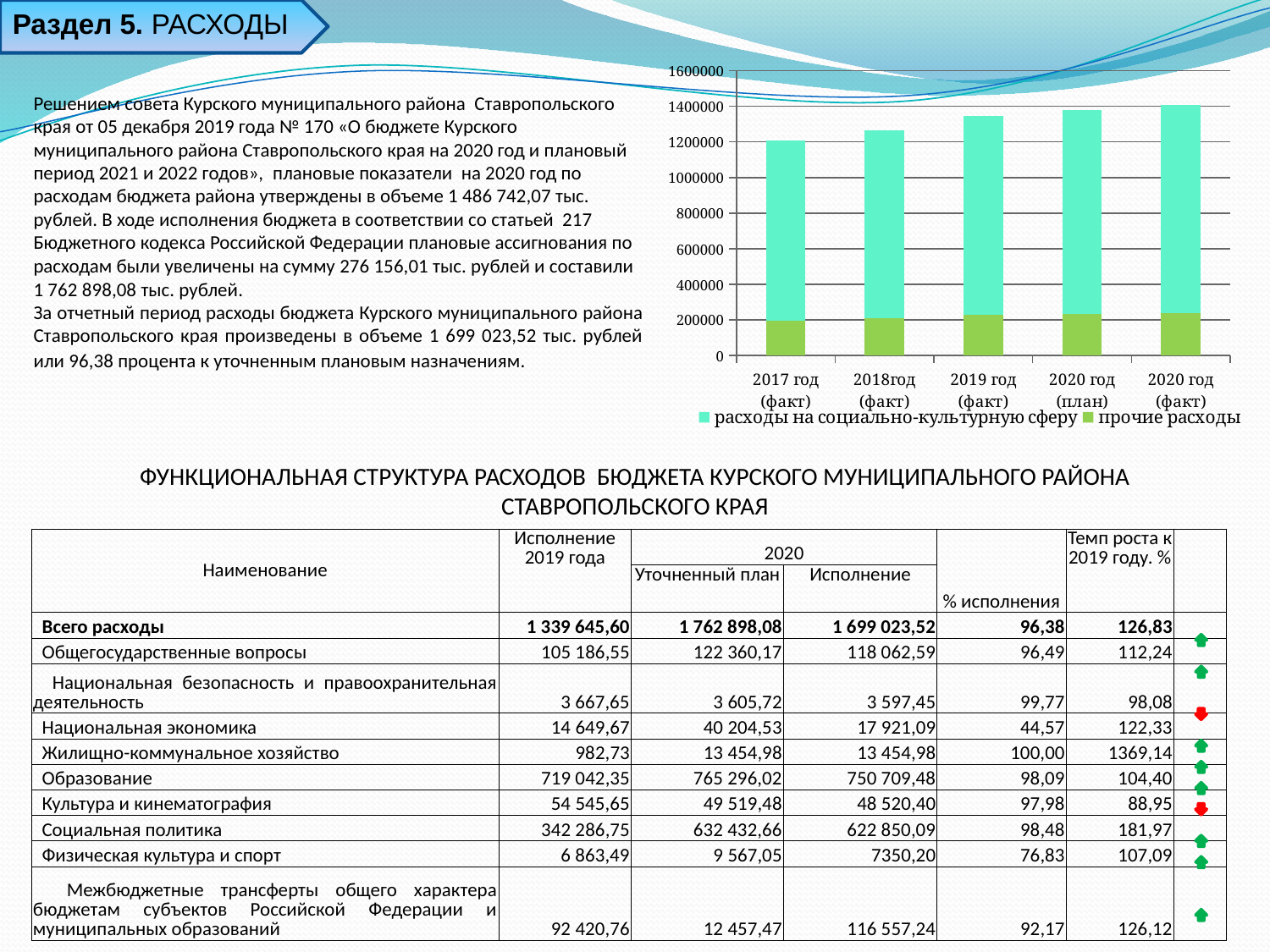
Which series is shown in green (the lower segment of each bar)? прочие расходы Which has the larger total bar, 2019 год (факт) or 2020 год (план)? 2020 год (план) Which year category has the lowest total bar? 2017 год (факт) Which has the larger total bar, 2017 год (факт) or 2018год (факт)? 2018год (факт) Is the total bar for 2019 год (факт) greater or less than 1200000? greater How many series does the chart legend list? 2 Is the total bar for 2020 год (факт) greater or less than 1600000? less What kind of chart is shown on the slide? stacked bar chart Is the total bar for 2017 год (факт) greater or less than 1000000? greater Which series is shown in teal (the larger, upper segment of each bar)? расходы на социально-культурную сферу Do the total bar heights rise or fall from 2017 год (факт) to 2020 год (факт)? rise How many year categories are shown on the x axis of the chart? 5